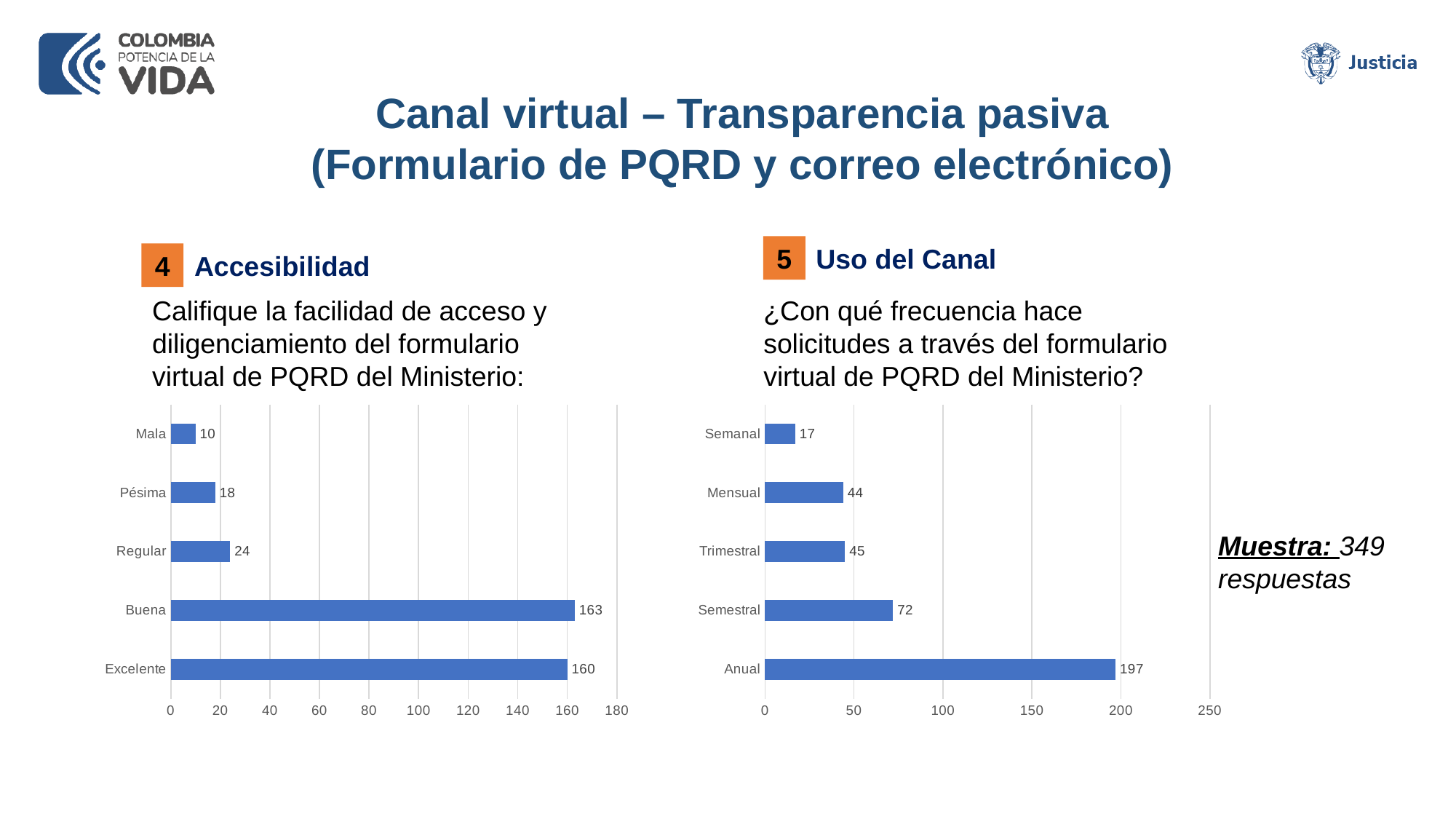
In the Uso del Canal chart on the right, which category has the highest value? Anual In the Accesibilidad chart on the left, what is the value for Regular? 24 In the Uso del Canal chart on the right, what is the difference between Semestral and Trimestral? 27 In the Uso del Canal chart on the right, what is the value for Semestral? 72 In the Accesibilidad chart on the left, which category has the lowest value? Mala In the Accesibilidad chart on the left, what is the value for Buena? 163 In the Uso del Canal chart on the right, which is larger, Mensual or Semanal? Mensual In the Uso del Canal chart on the right, what is the value for Anual? 197 What type of chart is the Uso del Canal chart on the right? Bar chart In the Accesibilidad chart on the left, how many categories are shown? 5 In the Accesibilidad chart on the left, is the value for Pésima greater or less than 20? less In the Accesibilidad chart on the left, what is the difference between Buena and Excelente? 3